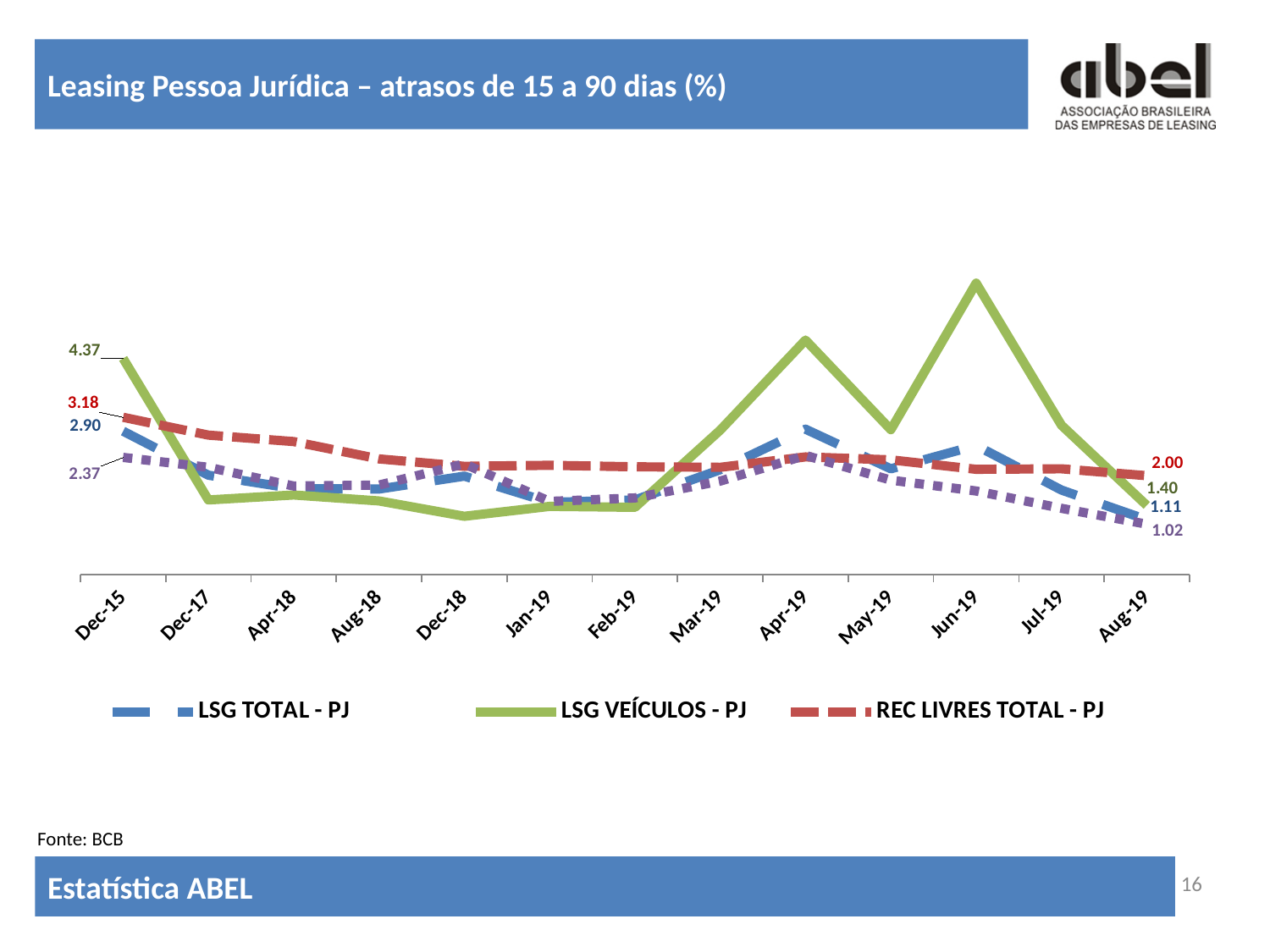
By how much did LSG VEÍCULOS - PJ fall between Dec-15 and Aug-19? 2.97 What is the value of LSG TOTAL - PJ at Dec-15? 2.90 What is the value of LSG TOTAL - PJ at Aug-19? 1.11 In which month does the LSG VEÍCULOS - PJ line reach its highest point? Jun-19 What kind of chart is shown on the slide? Line chart What is the value of LSG VEÍCULOS - PJ at Aug-19? 1.40 What is the value of LSG VEÍCULOS - PJ at Dec-15? 4.37 What is the value of REC LIVRES TOTAL - PJ at Aug-19? 2.00 What is the title of the chart? Leasing Pessoa Jurídica – atrasos de 15 a 90 dias (%) How many series does the legend list? 3 How many time points are shown on the x axis? 13 What is the value of REC LIVRES TOTAL - PJ at Dec-15? 3.18